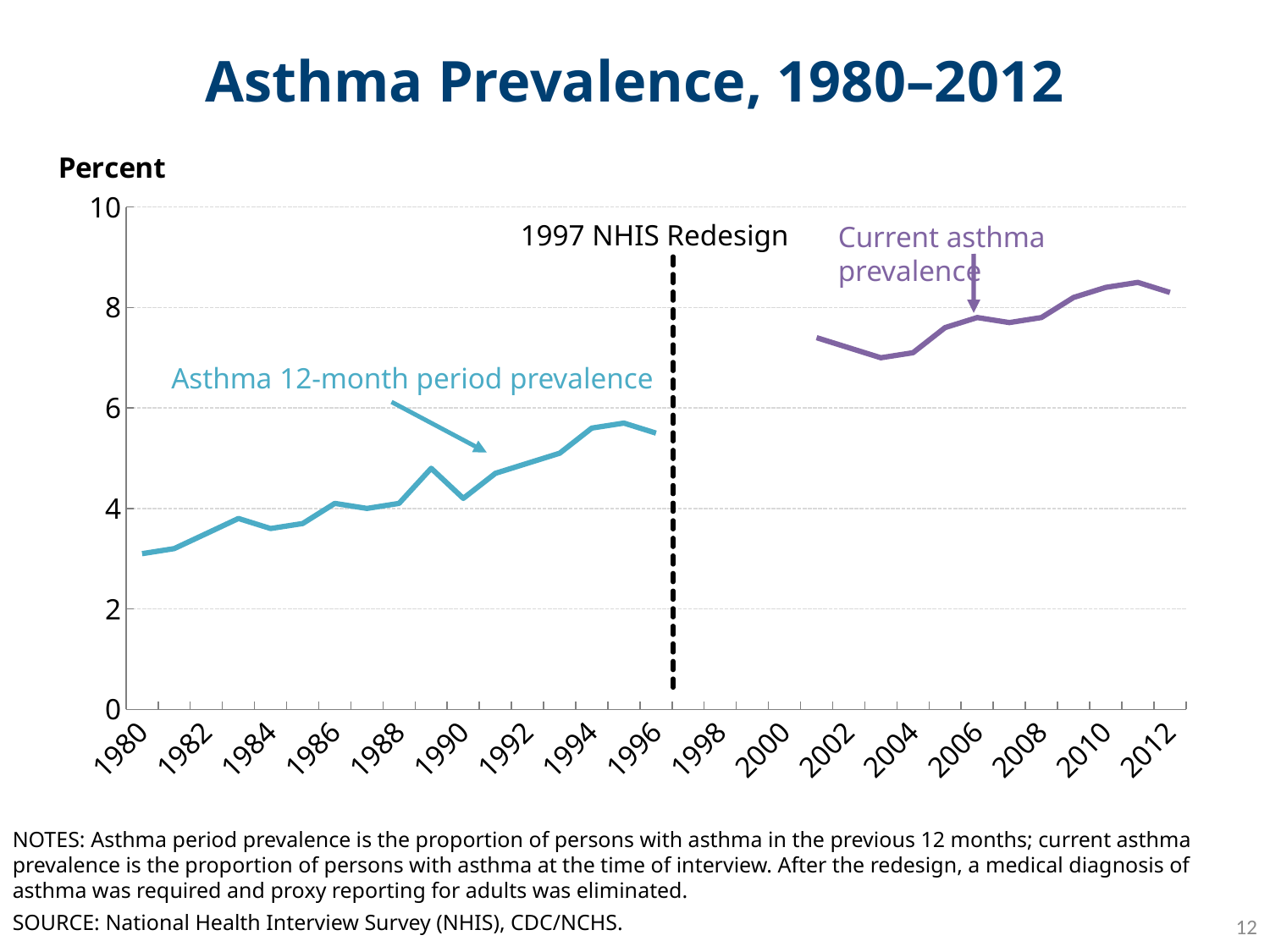
What kind of chart is shown on the slide? line chart Is the asthma 12-month period prevalence for 1980 greater or less than 4? less Does the asthma 12-month period prevalence generally rise or fall from 1980 to 1996? rise How many data series are plotted on the chart? 2 What unit is the vertical axis labelled with? Percent Is the current asthma prevalence for 2003 greater or less than 6? greater Is the asthma 12-month period prevalence for 1996 greater or less than 6? less In which year is the asthma 12-month period prevalence lowest? 1980 Which is larger: the current asthma prevalence in 2012 or the asthma 12-month period prevalence in 1996? current asthma prevalence in 2012 Does the current asthma prevalence generally rise or fall from 2001 to 2012? rise What is the title of the chart? Asthma Prevalence, 1980–2012